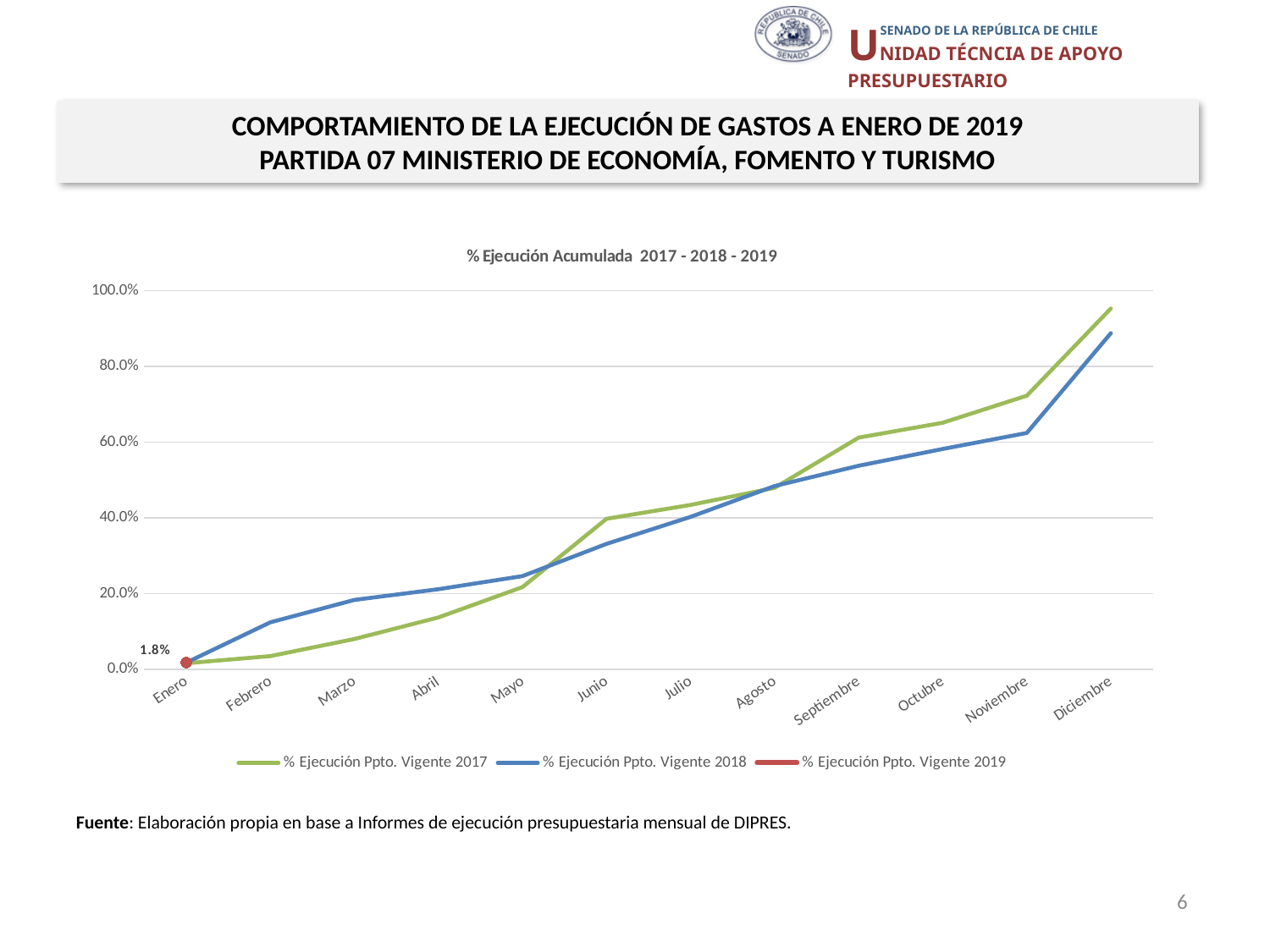
What is the title of the chart? % Ejecución Acumulada 2017 - 2018 - 2019 How many months are shown along the x axis? 12 Is the value for % Ejecución Ppto. Vigente 2018 in Diciembre greater or less than 80.0%? greater In Diciembre, which series has the higher value: % Ejecución Ppto. Vigente 2017 or % Ejecución Ppto. Vigente 2018? % Ejecución Ppto. Vigente 2017 Do the values for % Ejecución Ppto. Vigente 2017 rise or fall from Enero to Diciembre? rise Is the value for % Ejecución Ppto. Vigente 2017 in Marzo greater or less than 20.0%? less What is the value for % Ejecución Ppto. Vigente 2019 in Enero? 1.8% How many series does the legend list? 3 What kind of chart is shown on the slide? line chart Is the value for % Ejecución Ppto. Vigente 2017 in Diciembre greater or less than 80.0%? greater In Marzo, which series has the higher value: % Ejecución Ppto. Vigente 2017 or % Ejecución Ppto. Vigente 2018? % Ejecución Ppto. Vigente 2018